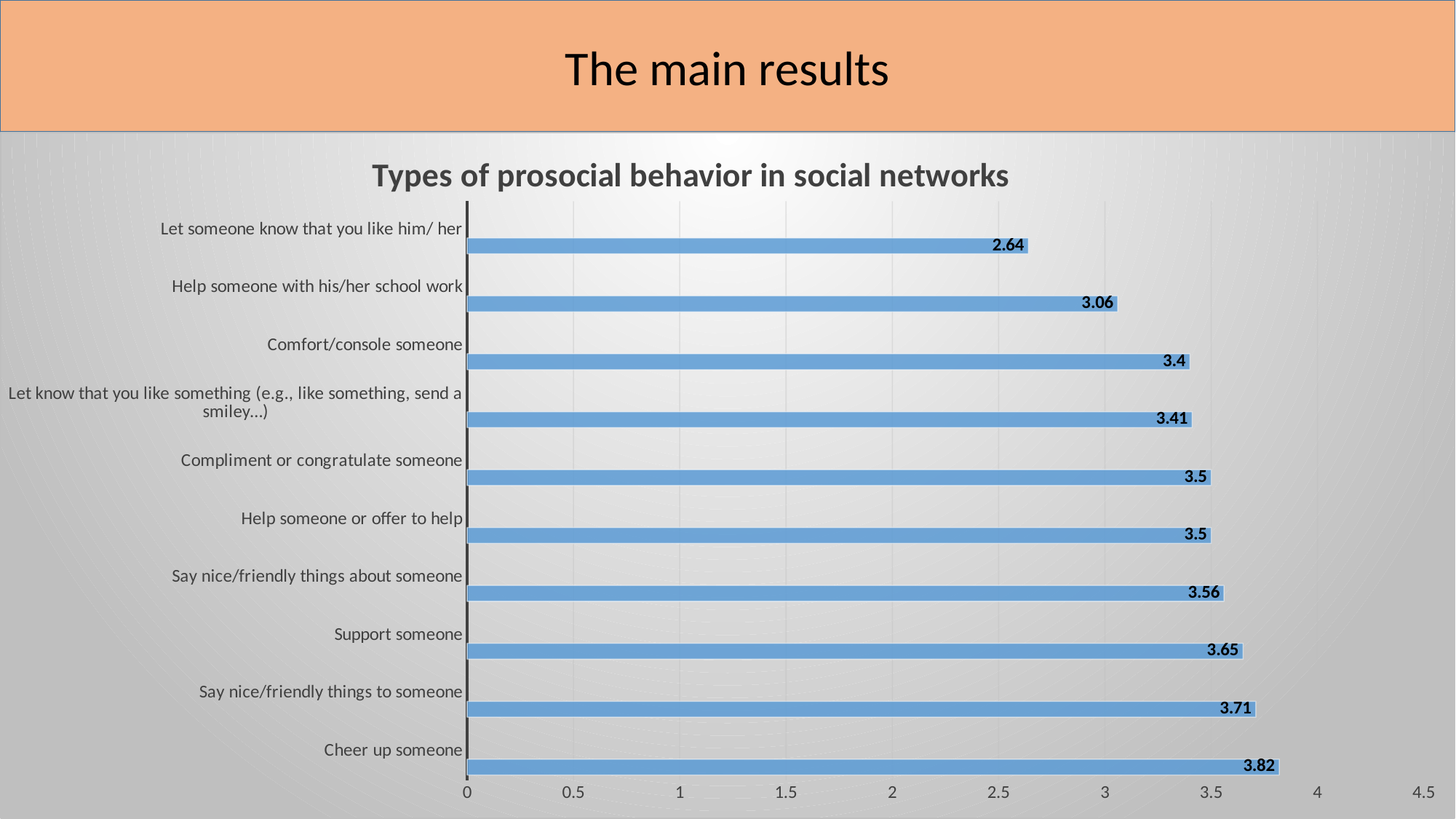
Is the value for "Comfort/console someone" greater or less than 3? greater What is the value for "Cheer up someone"? 3.82 What is the value for "Help someone with his/her school work"? 3.06 Is the value for "Let someone know that you like him/ her" greater or less than 3? less Which is larger, the value for "Say nice/friendly things to someone" or the value for "Say nice/friendly things about someone"? Say nice/friendly things to someone What is the difference between the values for "Cheer up someone" and "Let someone know that you like him/ her"? 1.18 What is the value for "Support someone"? 3.65 Which category has the highest value? Cheer up someone What kind of chart is shown on the slide? Bar chart What is the title of the chart? Types of prosocial behavior in social networks How many categories are shown in the chart? 10 Which category has the lowest value? Let someone know that you like him/ her